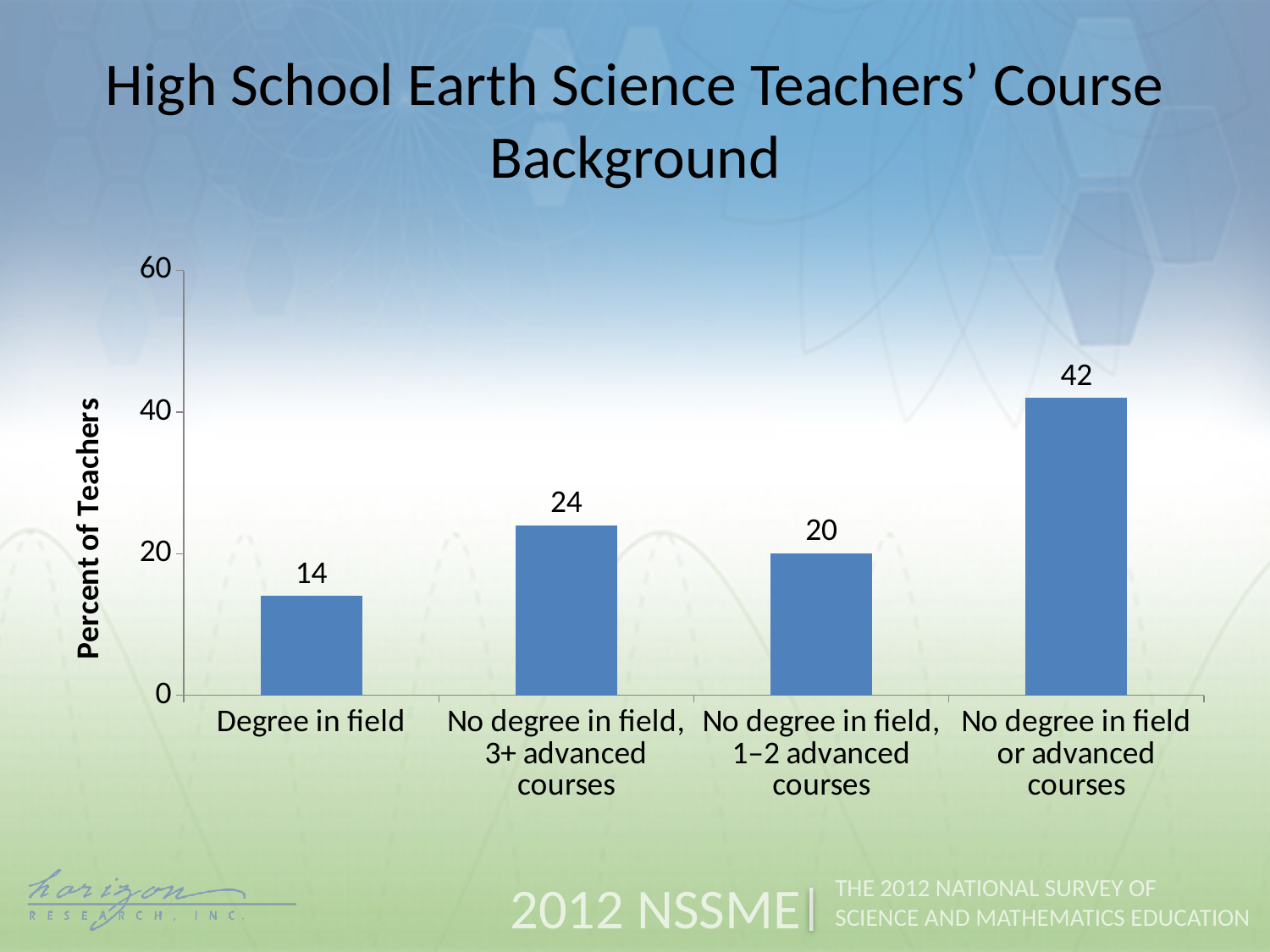
What is the value for 'No degree in field, 3+ advanced courses'? 24 What is the value for 'No degree in field or advanced courses'? 42 What percent of teachers have a degree in field? 14 How many categories are shown on the x axis? 4 Which is larger: 'No degree in field, 3+ advanced courses' or 'No degree in field, 1–2 advanced courses'? No degree in field, 3+ advanced courses What kind of chart is shown on the slide? Bar chart Which category has the lowest percent of teachers? Degree in field What is the difference between 'No degree in field or advanced courses' and 'Degree in field'? 28 What is the value for 'No degree in field, 1–2 advanced courses'? 20 What is the label of the y axis? Percent of Teachers Is the value for 'No degree in field or advanced courses' greater or less than 40? greater Which category has the highest percent of teachers? No degree in field or advanced courses